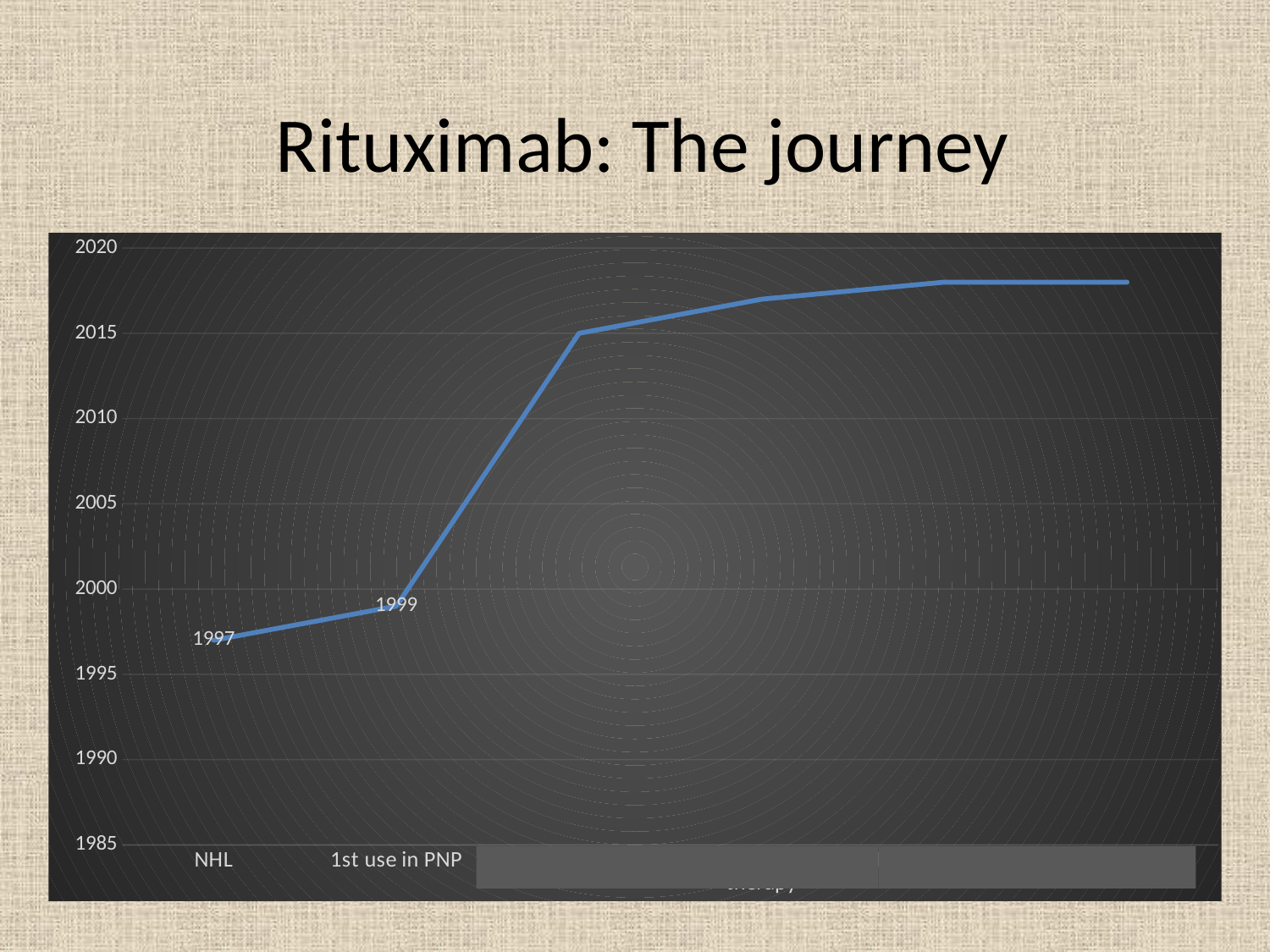
What kind of chart is shown on the slide? Line chart What is the title of the slide? Rituximab: The journey Which is later, the year for NHL or the year for 1st use in PNP? 1st use in PNP How many years separate the NHL point from the 1st use in PNP point? 2 Do the values rise or fall from left to right along the x axis? Rise How many data points are plotted on the line? 6 What year is shown for NHL? 1997 Is the value for 1st use in PNP greater or less than 2000? less Is the value for NHL greater or less than 2000? less What is the highest value shown on the vertical axis? 2020 What year is shown for 1st use in PNP? 1999 Which category has the lowest value on the chart? NHL